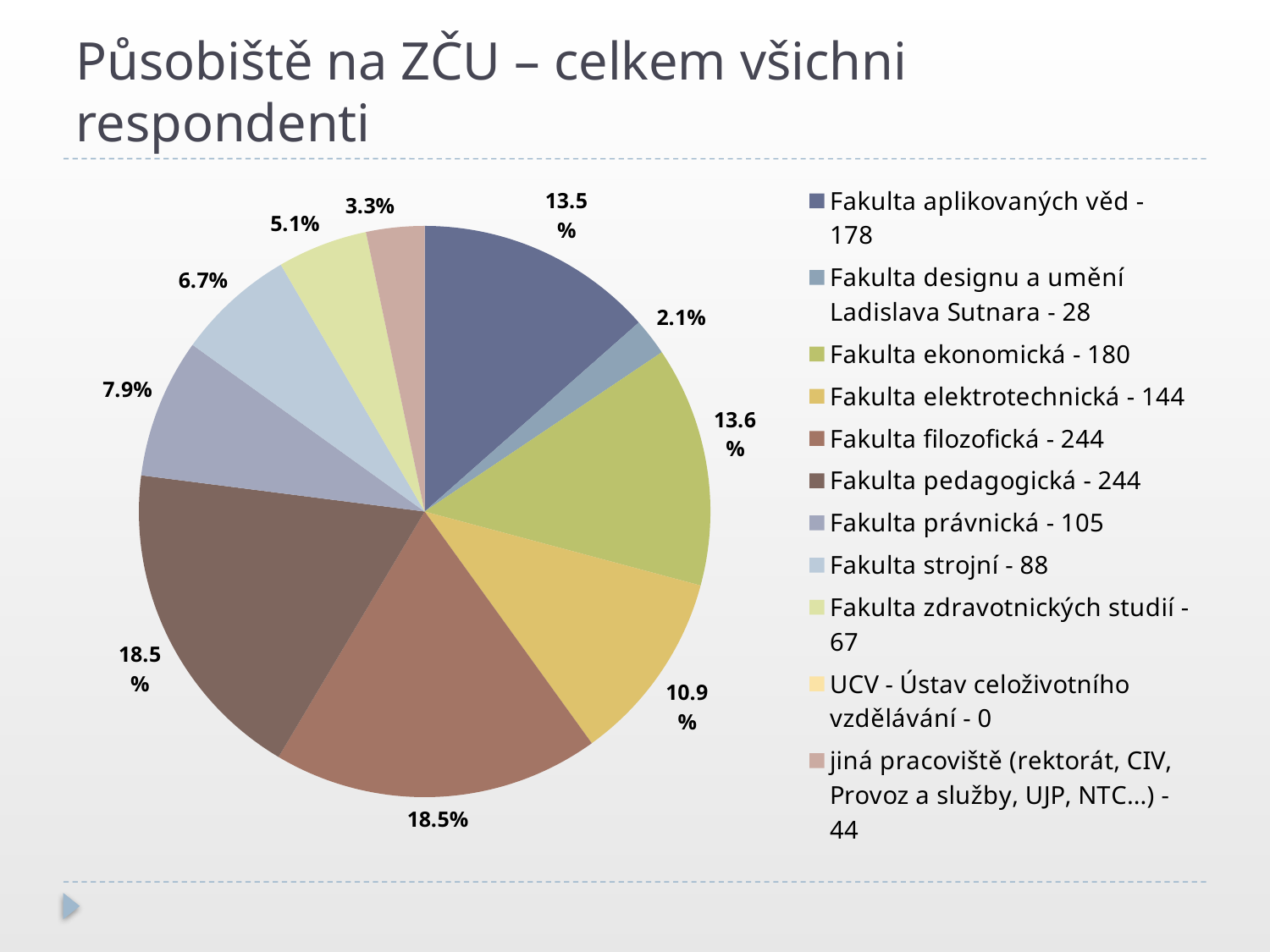
What kind of chart is shown on the slide? pie chart What percentage share does Fakulta strojní have? 6.7% What is the difference in percentage share between Fakulta pedagogická and Fakulta elektrotechnická? 7.6% What percentage share does Fakulta aplikovaných věd have in the pie chart? 13.5% What percentage share does Fakulta elektrotechnická have? 10.9% How many respondents does the legend list for Fakulta filozofická? 244 How many respondents does the legend list for UCV - Ústav celoživotního vzdělávání? 0 What is the title of the slide containing the pie chart? Působiště na ZČU – celkem všichni respondenti How many entries does the legend list? 11 Which has the larger share: Fakulta právnická or Fakulta strojní? Fakulta právnická How many respondents does the legend list for Fakulta právnická? 105